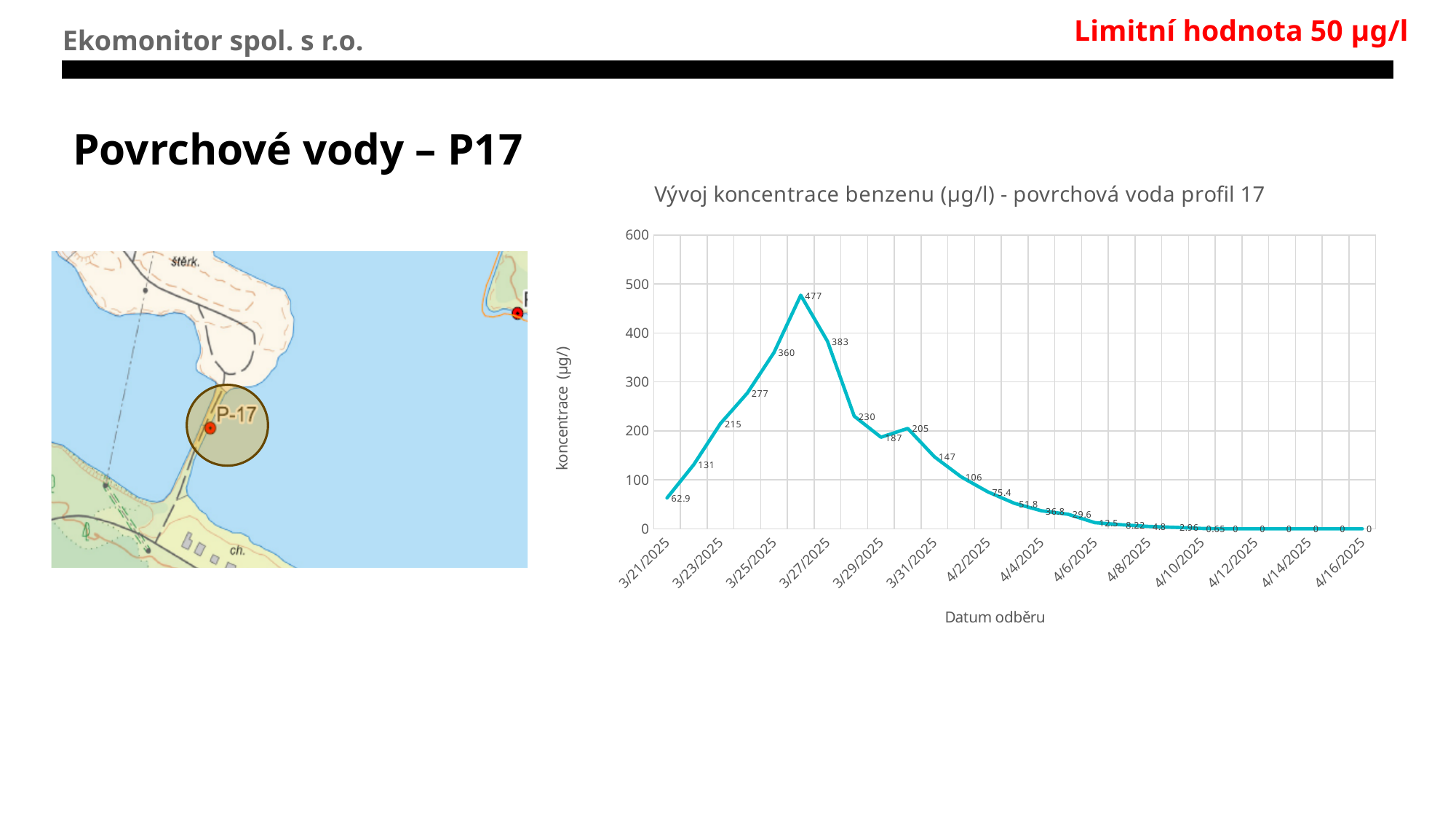
What is the benzene concentration on 4/2/2025? 75.4 What is the benzene concentration on 3/25/2025? 360 Is the concentration on 4/4/2025 greater or less than 100? less What is the benzene concentration on 3/21/2025? 62.9 What is the benzene concentration on 4/10/2025? 0.65 What is the title of the chart? Vývoj koncentrace benzenu (µg/l) - povrchová voda profil 17 What is the difference between the concentration on 3/27/2025 and on 3/29/2025? 196 What is the label of the x axis? Datum odběru What is the benzene concentration on 3/27/2025? 383 What type of chart is shown on the slide? line chart What is the highest benzene concentration value shown on the chart? 477 Which date has the higher concentration, 3/23/2025 or 3/31/2025? 3/23/2025